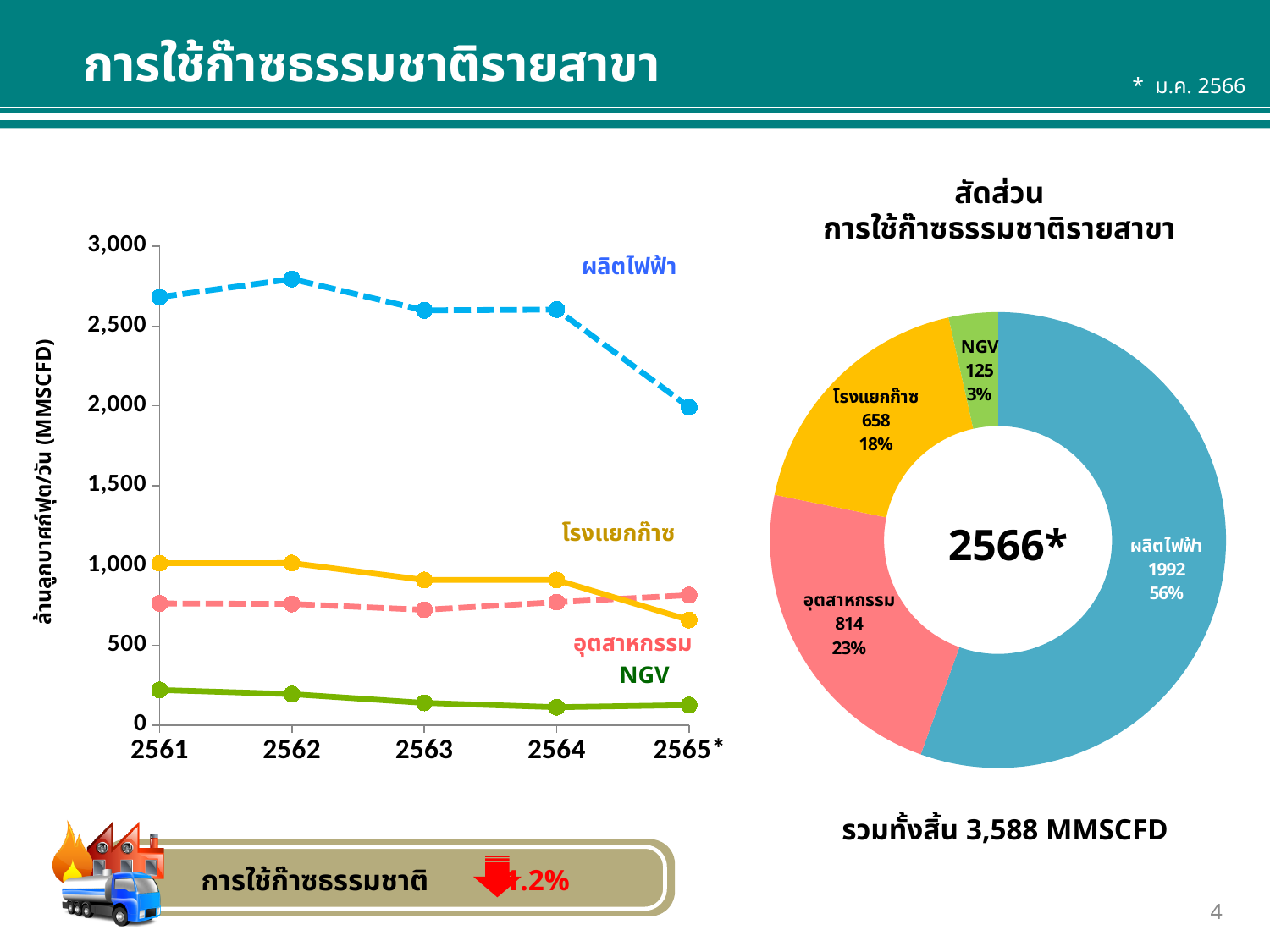
In the donut chart on the right, which sector has the smallest share? NGV How many years are shown on the x axis of the line chart on the left? 5 In the line chart on the left, does the ผลิตไฟฟ้า series rise or fall between 2564 and 2565*? Fall In the donut chart on the right, what is the value shown for ผลิตไฟฟ้า? 1992 In the donut chart on the right, what share of the total does อุตสาหกรรม account for? 23% In the line chart on the left, which is higher in 2565*, โรงแยกก๊าซ or อุตสาหกรรม? อุตสาหกรรม What kind of chart is the chart on the left side of the slide? Line chart What year label is shown in the centre of the donut chart on the right? 2566* How many sectors are shown in the donut chart on the right? 4 In the donut chart on the right, what is the difference between the values for อุตสาหกรรม and โรงแยกก๊าซ? 156 In the line chart on the left, is the value for ผลิตไฟฟ้า in 2565* greater or less than 2,500? less In the donut chart on the right, which sector has the largest share? ผลิตไฟฟ้า